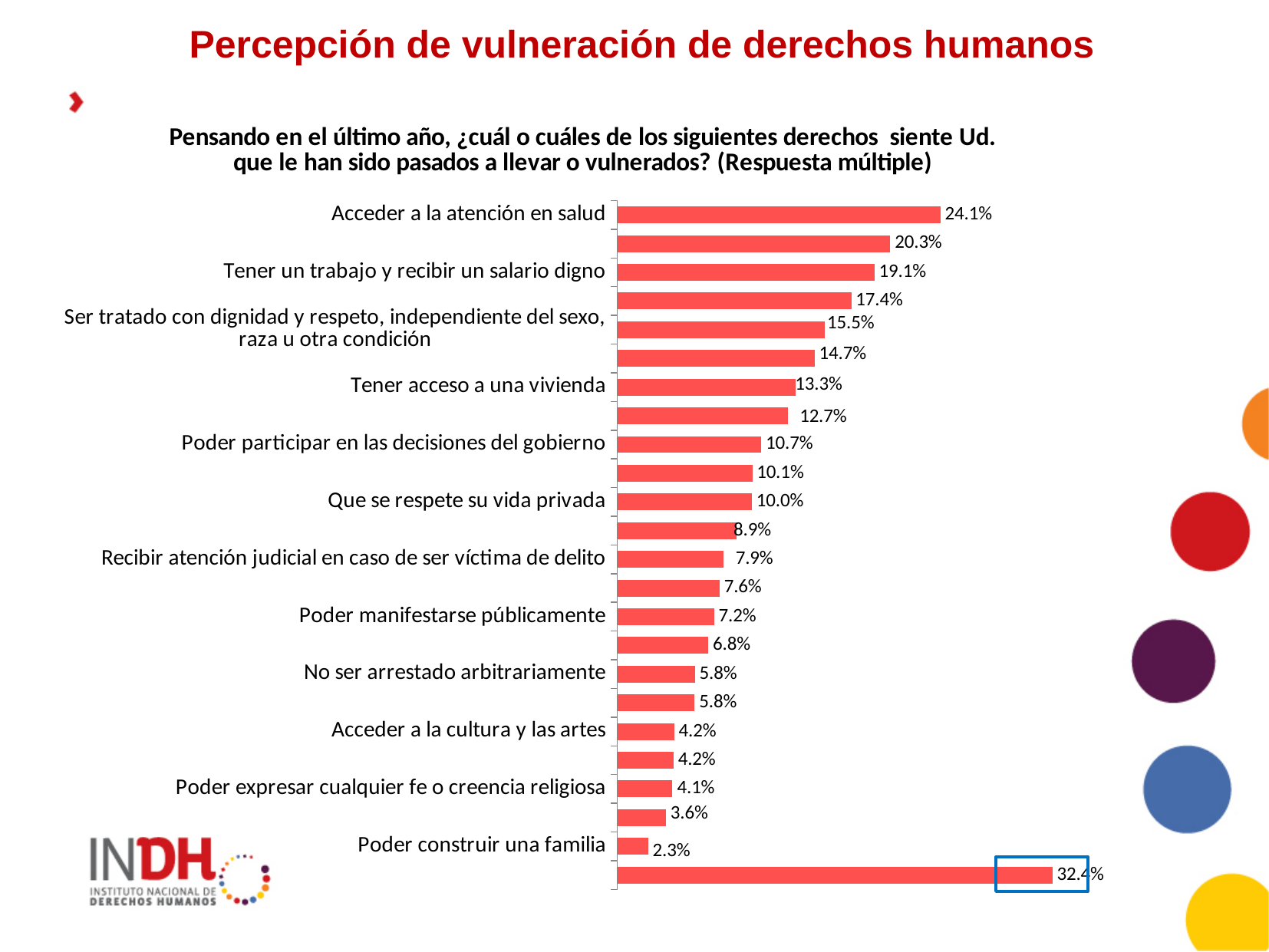
Which labeled category has the lowest value? Poder construir una familia What is the difference between "Acceder a la atención en salud" and "Tener un trabajo y recibir un salario digno"? 5.0% Which is larger, "Poder participar en las decisiones del gobierno" or "Que se respete su vida privada"? Poder participar en las decisiones del gobierno What is the value for "No ser arrestado arbitrariamente"? 5.8% What is the value for "Poder construir una familia"? 2.3% What is the difference between "Tener acceso a una vivienda" and "Poder construir una familia"? 11.0% What is the value for "Tener un trabajo y recibir un salario digno"? 19.1% How many bars are plotted on the chart? 24 What is the value for "Acceder a la atención en salud"? 24.1% What type of chart is shown on the slide? bar chart What is the largest value shown on the chart? 32.4% What is the value for "Tener acceso a una vivienda"? 13.3%